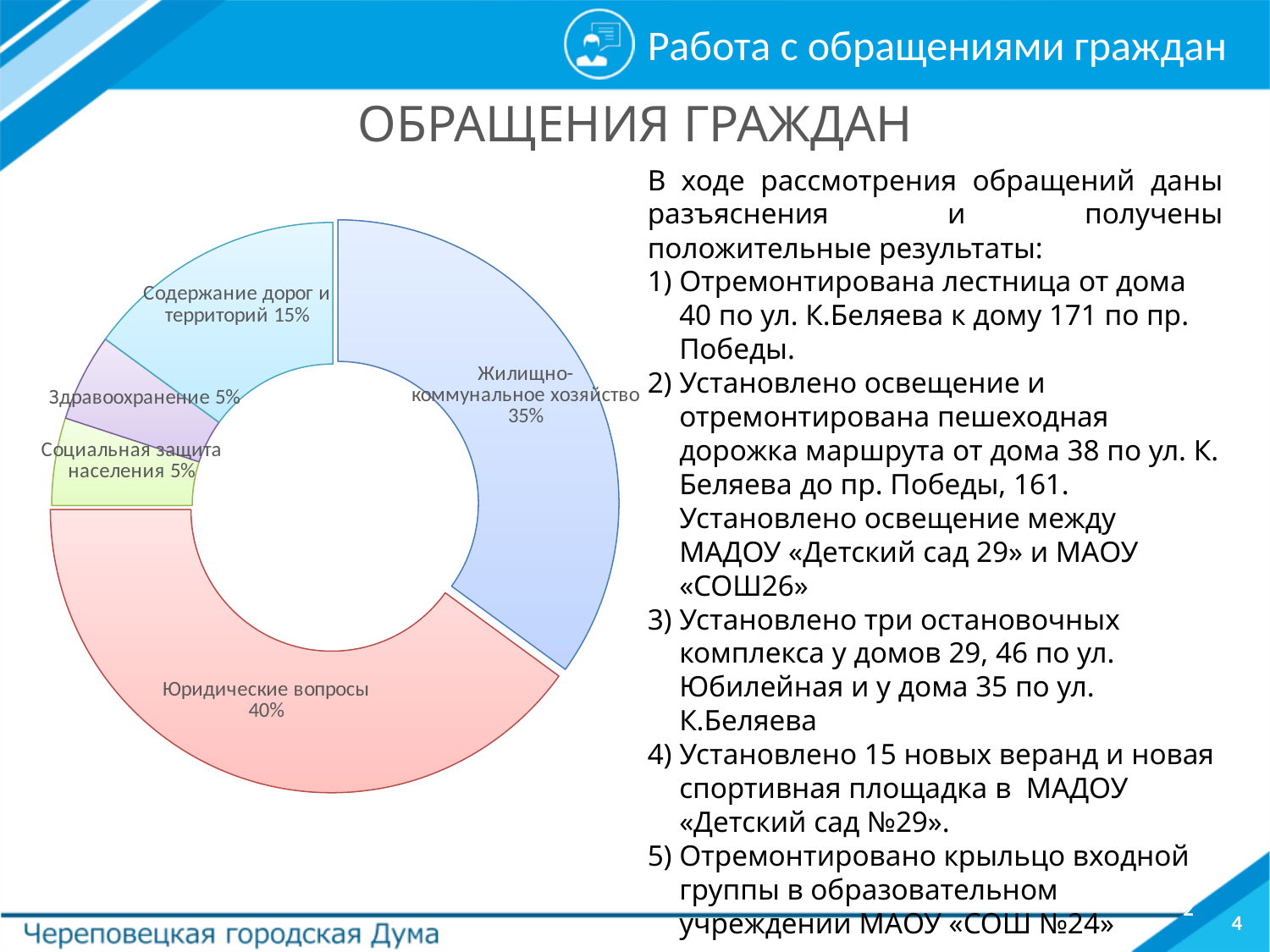
What kind of chart is shown on the slide? Pie (doughnut) chart What percentage is shown for Жилищно-коммунальное хозяйство? 35% What is the difference in percentage points between Юридические вопросы and Жилищно-коммунальное хозяйство? 5 What share of the chart does Юридические вопросы account for? 40% How many categories are shown in the chart? 5 Which is larger: the share for Содержание дорог и территорий or the share for Здравоохранение? Содержание дорог и территорий Which category has the largest share of the chart? Юридические вопросы What percentage is shown for Здравоохранение? 5% What is the value for Социальная защита населения? 5% What is the value for Содержание дорог и территорий? 15% What is the combined share of Здравоохранение and Социальная защита населения? 10% What is the heading above the chart on the slide? ОБРАЩЕНИЯ ГРАЖДАН